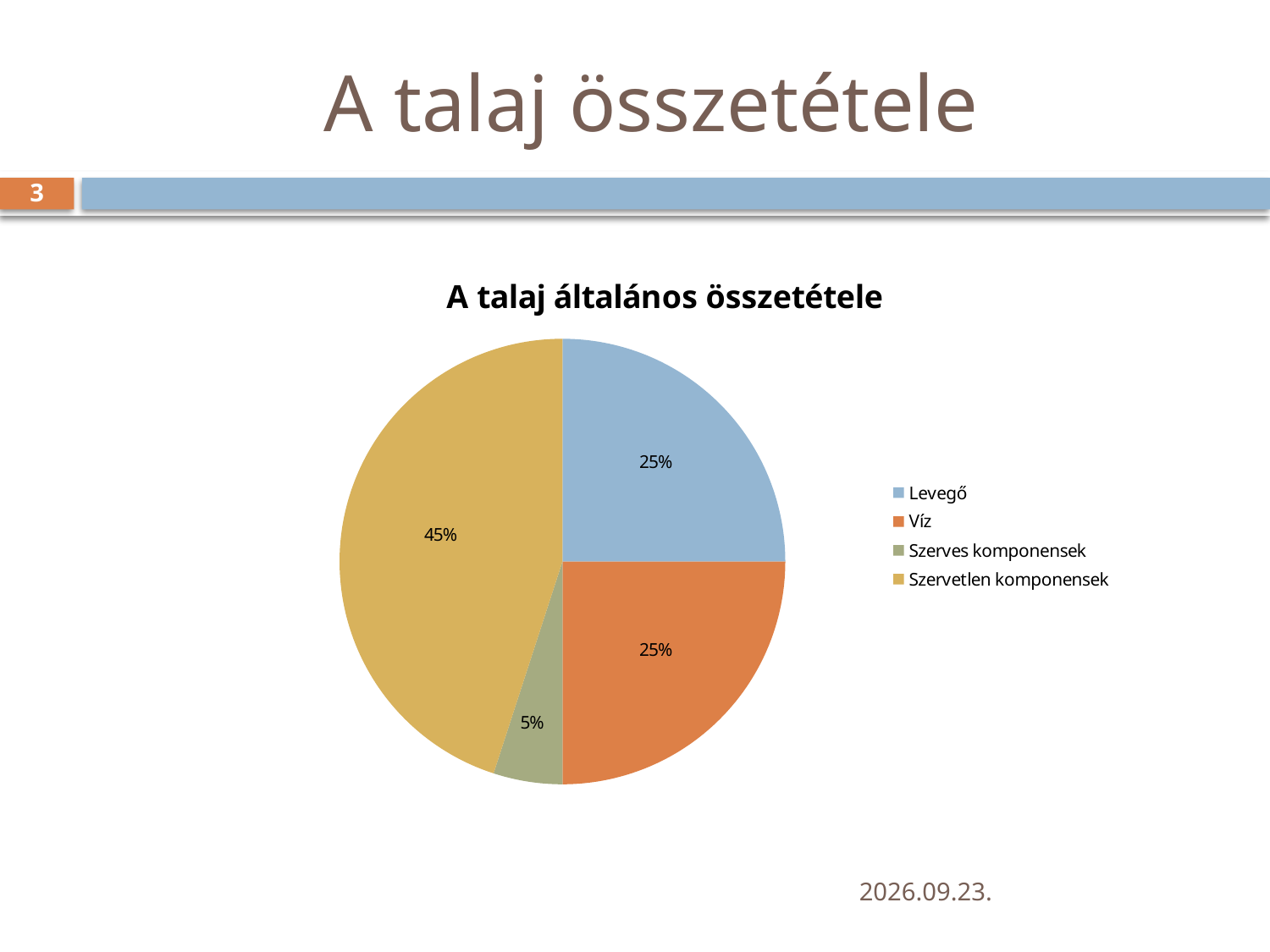
Which category has the smallest slice of the pie? Szerves komponensek Which is larger, the share for Víz or the share for Szerves komponensek? Víz What kind of chart is shown on the slide? pie chart What is the value shown for Víz? 25% What is the difference between the shares of Szervetlen komponensek and Szerves komponensek? 40% Which category has the largest slice of the pie? Szervetlen komponensek What is the value shown for Szerves komponensek? 5% What is the value shown for Levegő? 25% What colour is the slice for Szervetlen komponensek? yellow What share of the pie does Szervetlen komponensek take? 45% What is the title of the chart? A talaj általános összetétele How many categories does the legend list? 4